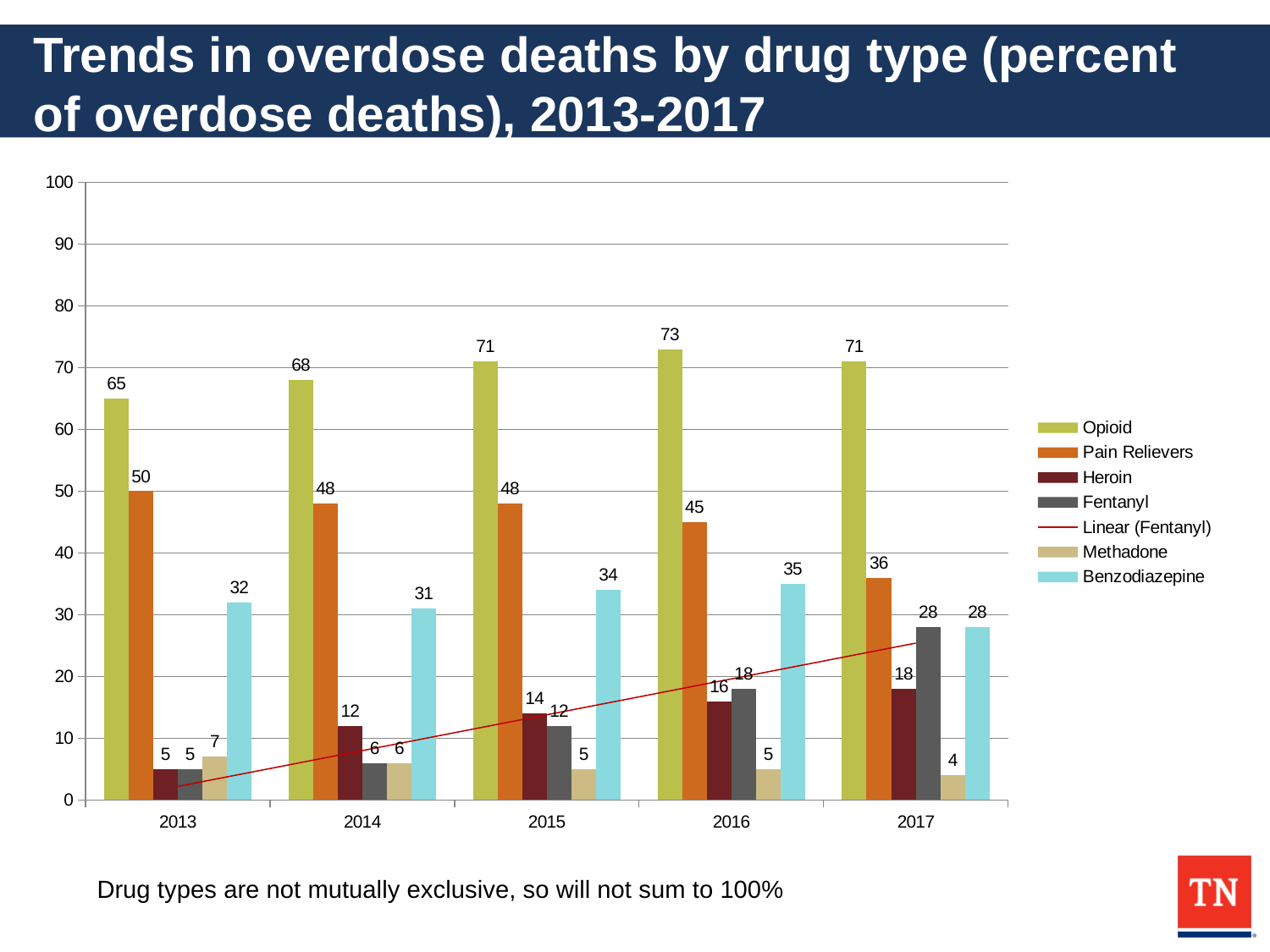
Which is larger in 2016, the Heroin value or the Fentanyl value? Fentanyl What is the Opioid value for 2016? 73 How many years are shown on the x axis? 5 What is the difference between the Pain Relievers values for 2013 and 2017? 14 What is the Fentanyl value for 2017? 28 Does the Fentanyl value rise or fall from 2013 to 2017? rise In which year is the Pain Relievers value lowest? 2017 Is the Benzodiazepine value for 2015 greater or less than 30? greater How many entries does the legend list? 7 In which year is the Opioid value highest? 2016 What kind of chart is this? bar chart What is the Pain Relievers value for 2013? 50